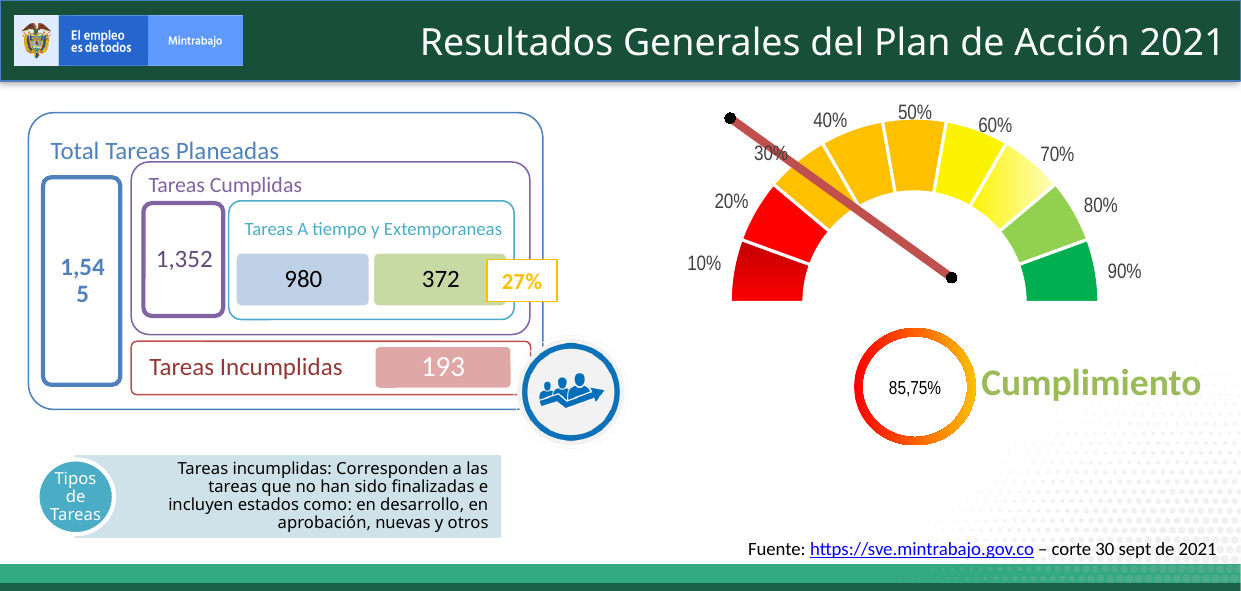
In the Total Tareas Planeadas diagram, what is the difference between the 980 and 372 values under Tareas A tiempo y Extemporaneas? 608 In the Total Tareas Planeadas diagram, which is larger: the blue box (980) or the green box (372) under Tareas A tiempo y Extemporaneas? 980 What is the highest percentage label shown on the gauge chart? 90% In the Total Tareas Planeadas diagram, what is the total number of planned tasks? 1,545 What is the lowest percentage label shown on the gauge chart? 10% In the Total Tareas Planeadas diagram, what is the value for Tareas Incumplidas? 193 What kind of chart is shown on the right side of the slide with the coloured semicircle segments? gauge chart What value is shown inside the ring labelled Cumplimiento? 85,75% How many percentage labels are shown around the gauge chart? 9 In the Total Tareas Planeadas diagram, what is the value for Tareas Cumplidas? 1,352 What colour is the 90% segment of the gauge chart? green What colour are the 10% and 20% segments of the gauge chart? red